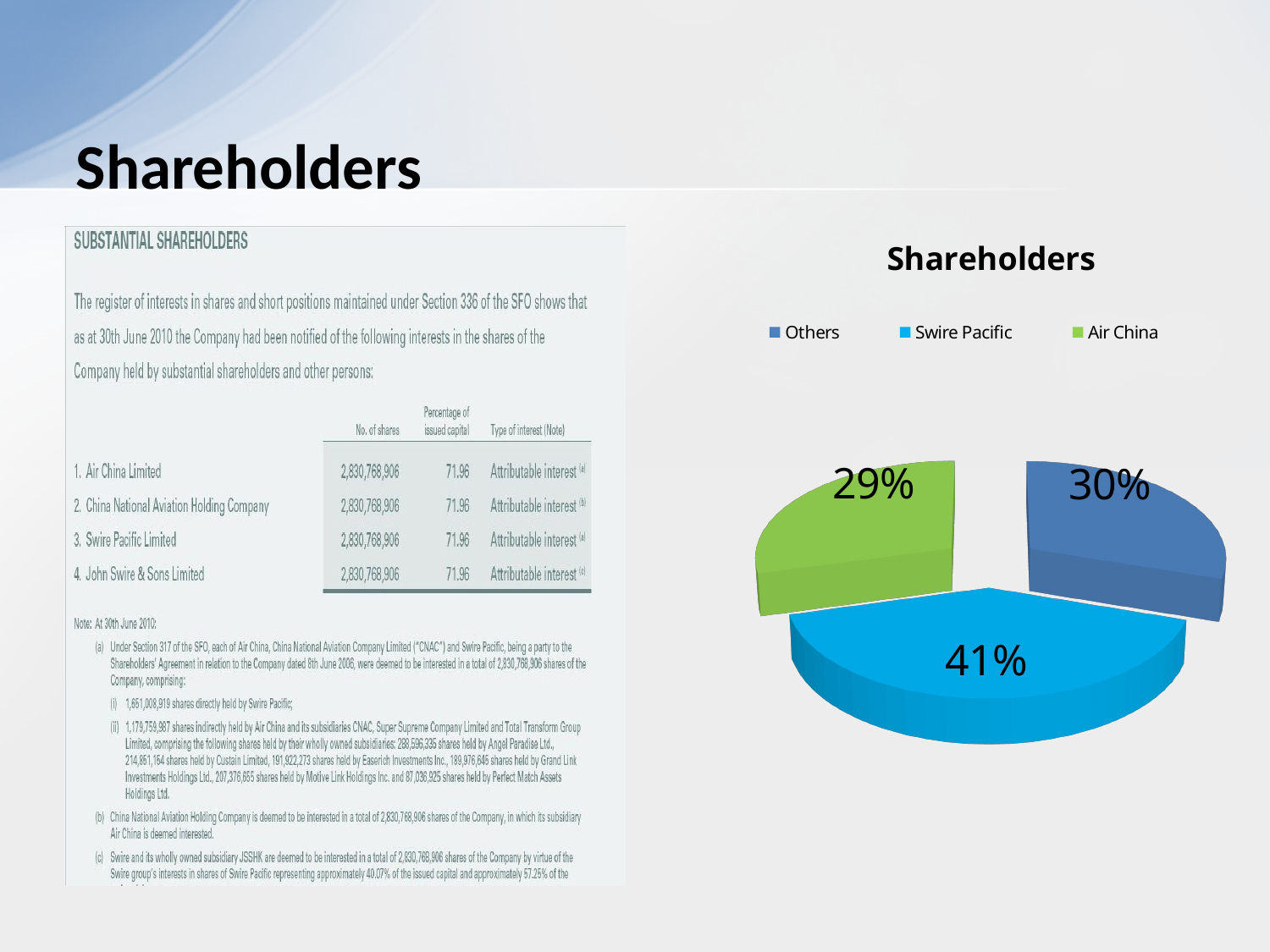
What kind of chart is shown on the slide? pie chart How many entries does the legend list? 3 What percentage does the Others slice show? 30% Which shareholder has the smallest share of the pie? Air China What colour is the Air China slice in the pie chart? green Which is larger, the Others slice or the Air China slice? Others What is the title of the chart? Shareholders Which shareholder has the largest share of the pie? Swire Pacific What is the difference in percentage points between the Swire Pacific slice and the Air China slice? 12 How many slices does the pie chart have? 3 What percentage does the Air China slice show? 29% What percentage does the Swire Pacific slice show? 41%